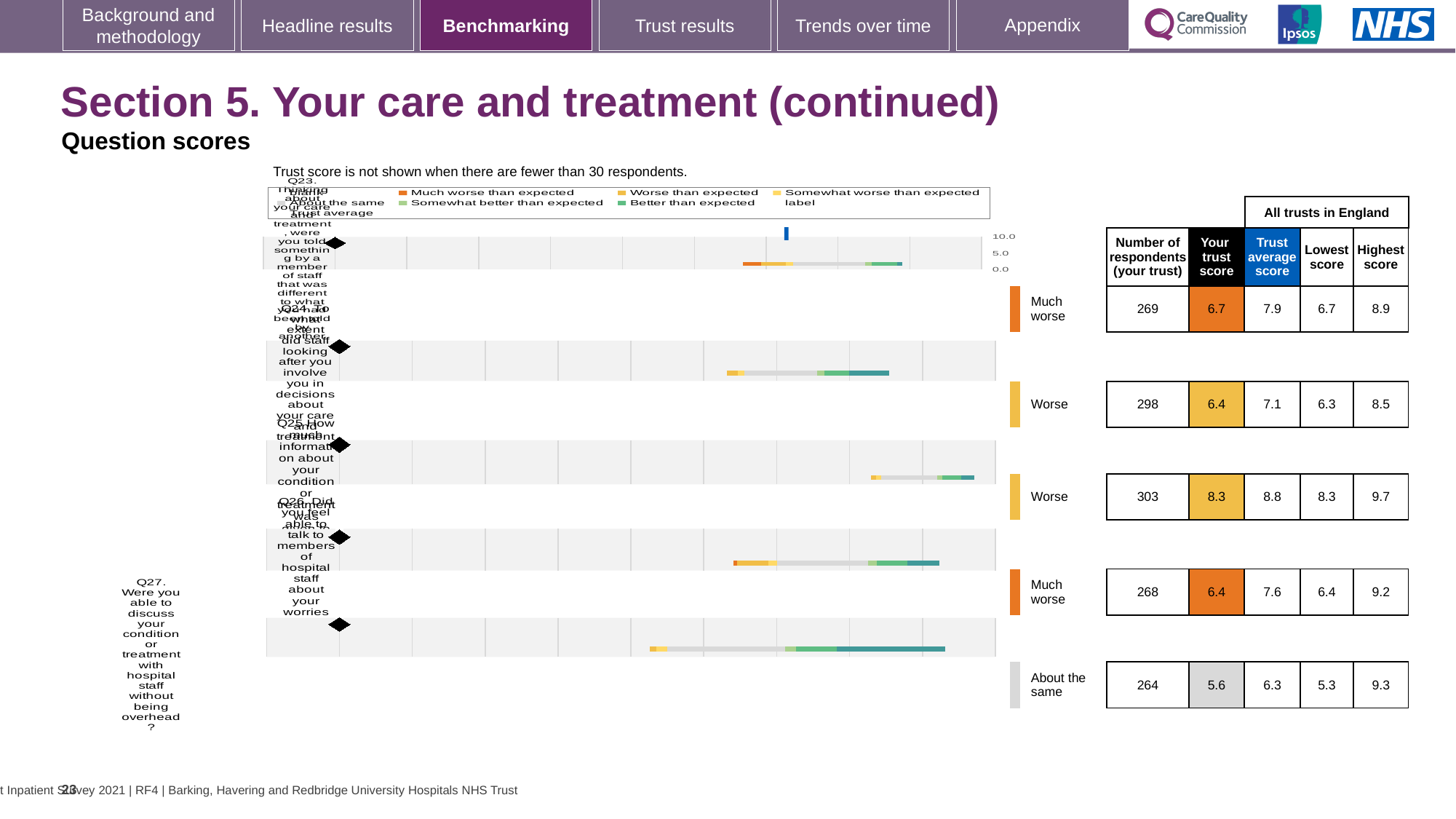
What benchmark category is shown for Q26? Much worse How many questions are plotted on the chart? 5 Which question has the highest trust score in the table? Q25 What is the lowest score across all trusts in England for Q27? 5.3 What is the trust score for Q23 shown in the table? 6.7 What is the difference between the trust average score and the trust score for Q23? 1.2 Which question has the lowest trust score in the table? Q27 What benchmark category is shown for Q27? About the same For Q24, which is larger: the trust score or the trust average score? Trust average score How many respondents are listed for Q24? 298 What is the highest score across all trusts in England for Q25? 9.7 What kind of chart is used to show the question scores? Bar chart